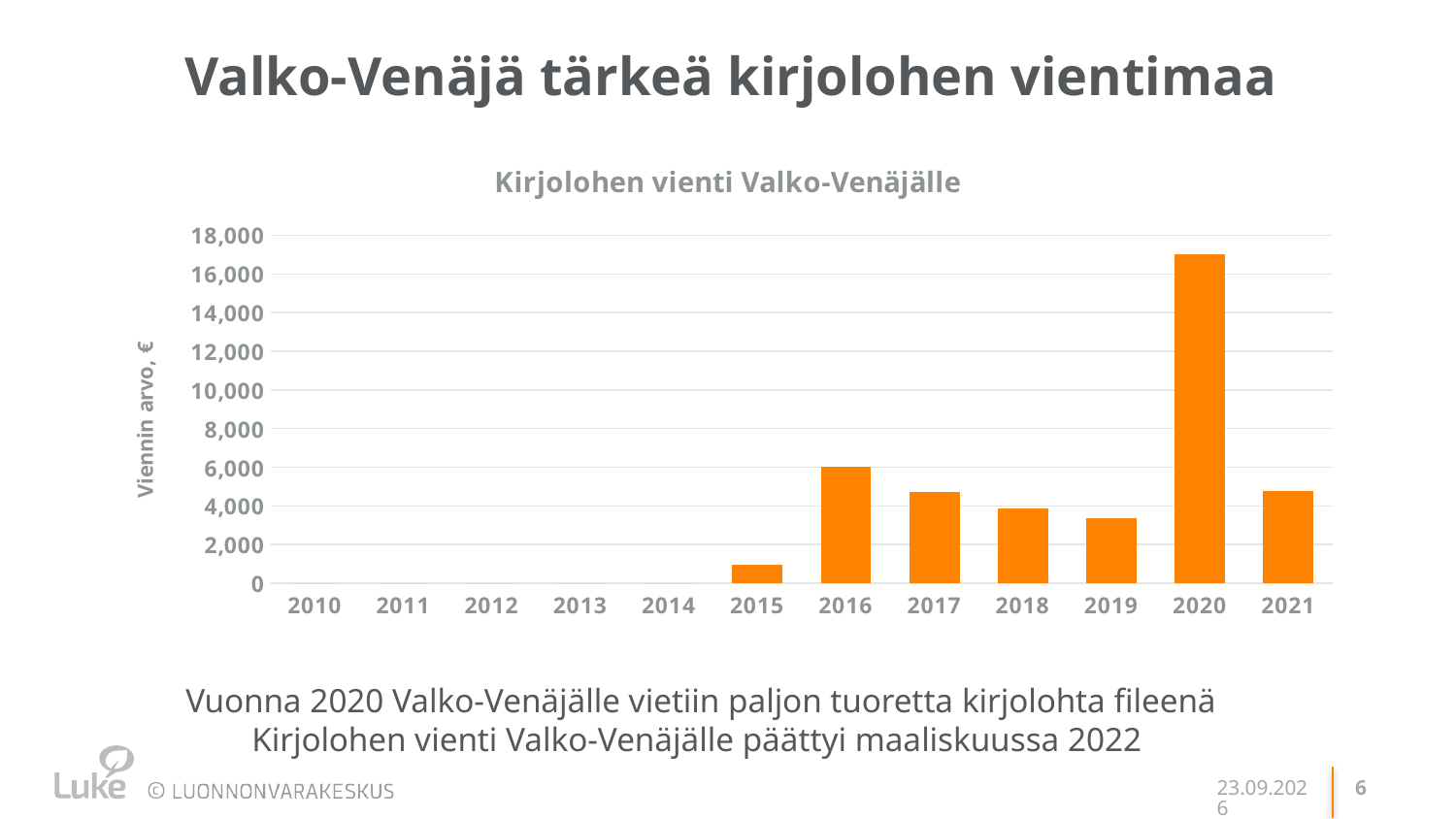
Is the value for 2019 greater or less than 4,000? less Is the value for 2020 greater or less than 16,000? greater Among the years with a visible bar, which year has the lowest value? 2015 Is the value for 2017 greater or less than 4,000? greater Which year has the highest bar? 2020 What is the title of the chart? Kirjolohen vienti Valko-Venäjälle What kind of chart is shown on the slide? bar chart What is the label of the vertical axis? Viennin arvo, € Which is larger, the value for 2016 or the value for 2019? 2016 How many years are shown on the x axis? 12